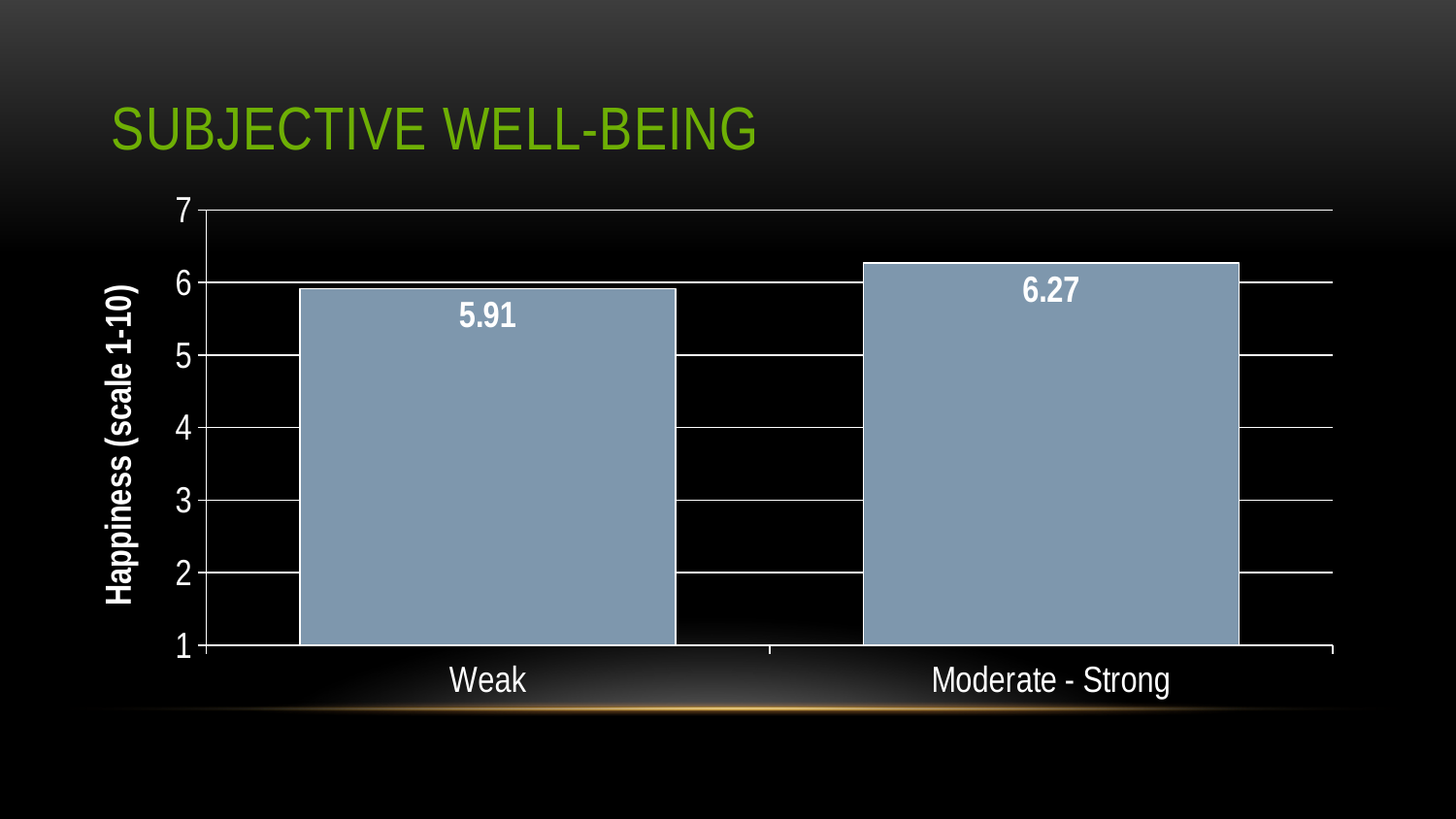
What is the happiness value for the Moderate - Strong category? 6.27 How many categories are shown on the x axis? 2 Which is larger, the happiness value for Weak or for Moderate - Strong? Moderate - Strong What is the title of the slide? SUBJECTIVE WELL-BEING Is the happiness value for Weak greater or less than 6? less What is the difference between the happiness values for Moderate - Strong and Weak? 0.36 What kind of chart is shown on the slide? bar chart What is the happiness value for the Weak category? 5.91 Which category has the highest happiness value? Moderate - Strong Is the happiness value for Moderate - Strong greater or less than 6? greater Which category has the lowest happiness value? Weak What is the label of the y axis? Happiness (scale 1-10)